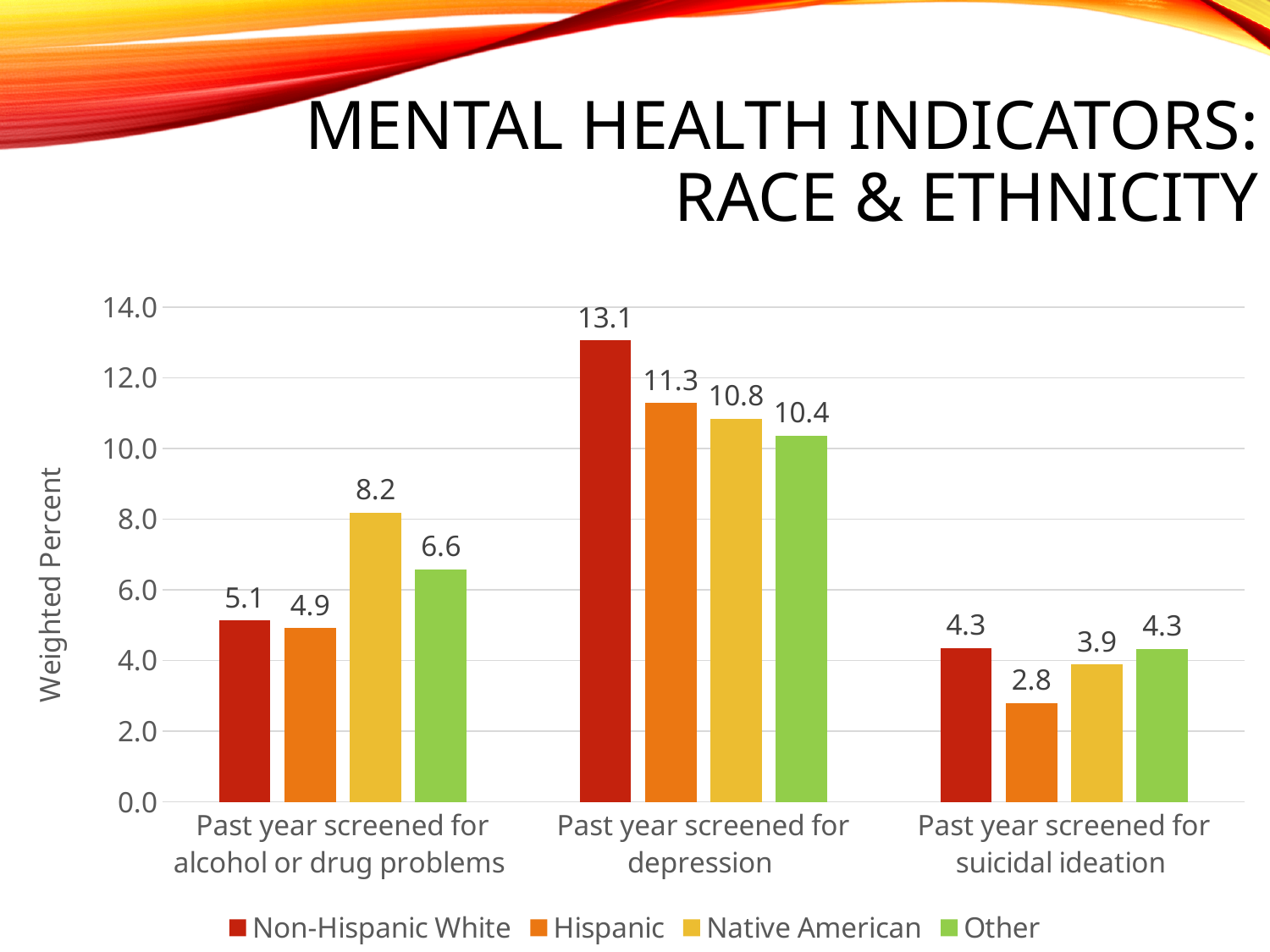
How many categories are shown on the x axis? 3 What is the value for Native American in the 'Past year screened for alcohol or drug problems' category? 8.2 Which series has the lowest value in the 'Past year screened for suicidal ideation' category? Hispanic Which is larger in the 'Past year screened for alcohol or drug problems' category: Native American or Other? Native American Which series has the highest value in the 'Past year screened for depression' category? Non-Hispanic White What is the value for Non-Hispanic White in the 'Past year screened for depression' category? 13.1 What kind of chart is shown on the slide? Bar chart What is the value for Hispanic in the 'Past year screened for suicidal ideation' category? 2.8 Is the value for Other in the 'Past year screened for depression' category greater or less than 10.0? greater What is the difference between the Non-Hispanic White and Hispanic values in the 'Past year screened for depression' category? 1.8 How many series does the legend list? 4 What is the label of the y axis? Weighted Percent